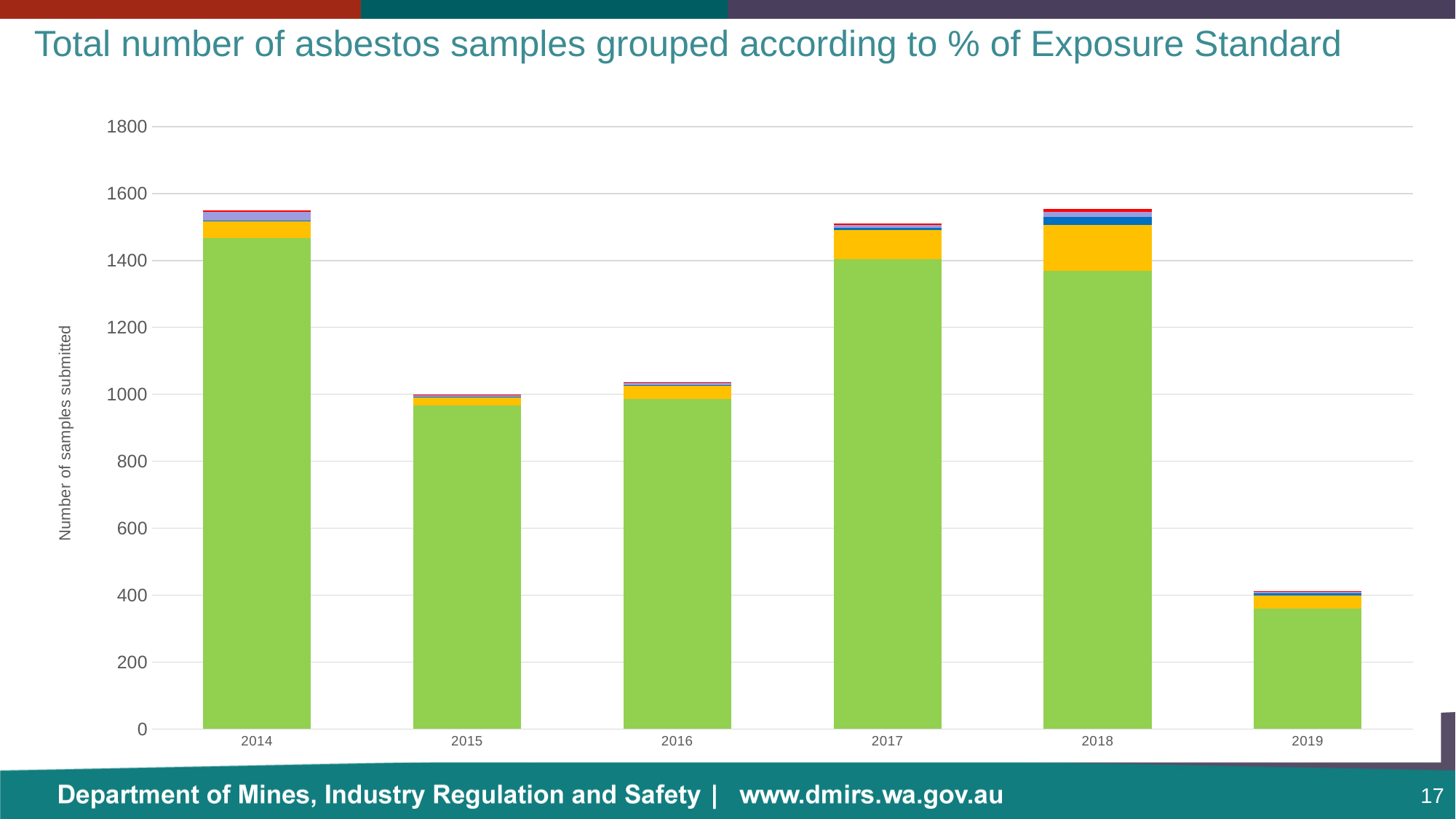
Which year has the lowest total number of samples submitted? 2019 Is the total for 2016 greater or less than 800? greater Is the total for 2015 greater or less than 1200? less Is the total for 2019 greater or less than 200? greater How many years are shown on the x axis of the chart? 6 What kind of chart is shown on the slide? stacked bar chart What colour is the largest segment in each stacked bar? green Which year has the larger total, 2017 or 2015? 2017 Do the totals rise or fall from 2015 to 2017? rise What is the label on the vertical axis of the chart? Number of samples submitted